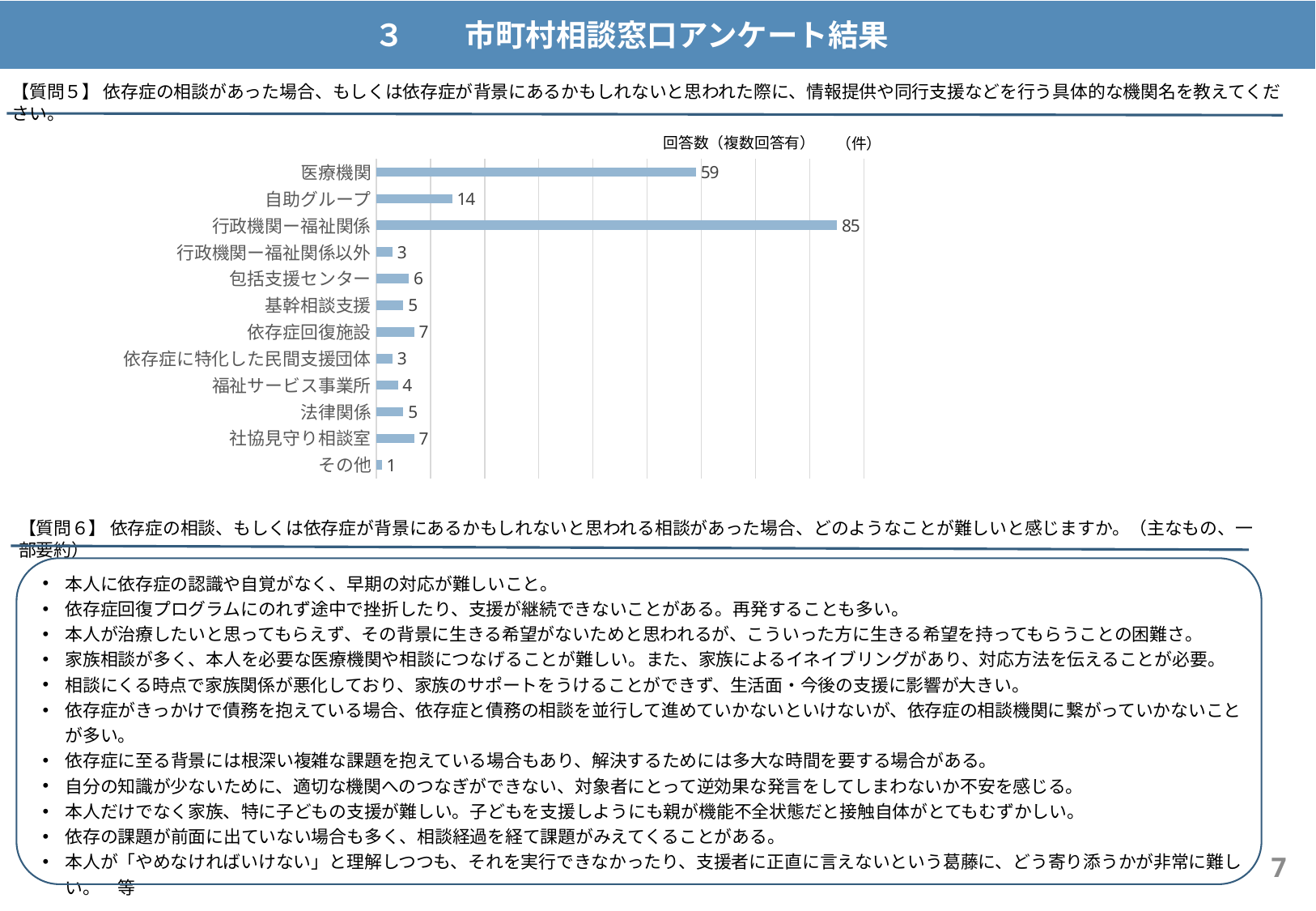
What kind of chart is shown on the slide? Bar chart Which is larger, the value for 包括支援センター or the value for 福祉サービス事業所? 包括支援センター What is the value for 社協見守り相談室 in the chart? 7 What is the difference between the values for 行政機関ー福祉関係 and 医療機関? 26 Which category has the lowest value in the chart? その他 What is the value for 医療機関 in the chart? 59 How many categories are shown in the chart? 12 What is the title of the chart? 回答数（複数回答有）（件） Which category has the highest value in the chart? 行政機関ー福祉関係 What is the value for 行政機関ー福祉関係以外 in the chart? 3 What is the value for 自助グループ in the chart? 14 What is the difference between the values for 自助グループ and 依存症回復施設? 7